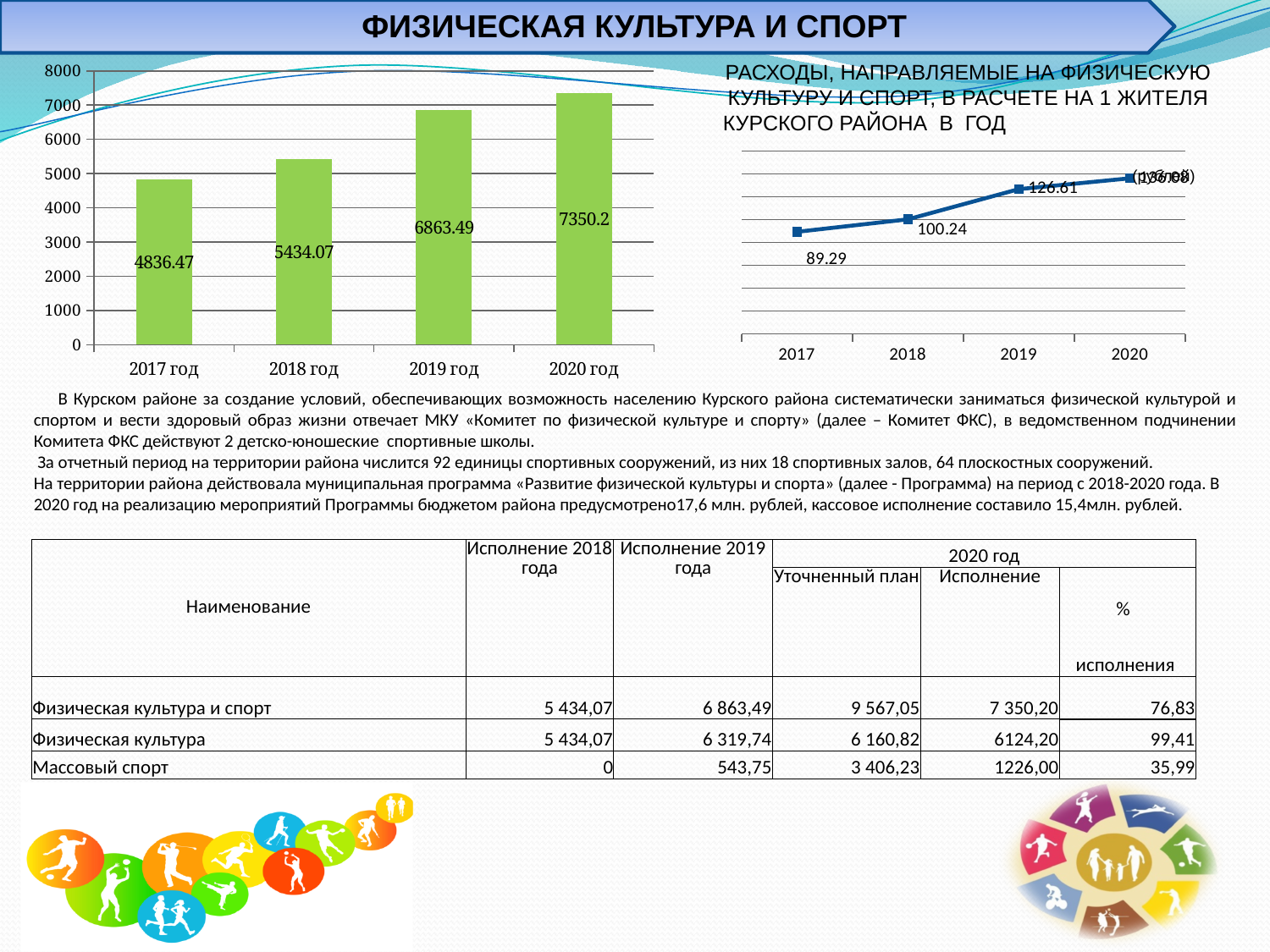
On the line chart on the right, which is larger, the value for 2019 or the value for 2018? 2019 On the line chart titled 'РАСХОДЫ, НАПРАВЛЯЕМЫЕ НА ФИЗИЧЕСКУЮ КУЛЬТУРУ И СПОРТ, В РАСЧЕТЕ НА 1 ЖИТЕЛЯ КУРСКОГО РАЙОНА В ГОД', what is the value for 2018? 100.24 On the bar chart on the left, which year has the highest value? 2020 год On the bar chart on the left, how many years are shown? 4 What kind of chart is the chart on the left of the slide? bar chart On the bar chart on the left, do the values rise or fall from 2017 год to 2020 год? rise On the bar chart on the left, what is the value for 2019 год? 6863.49 On the line chart titled 'РАСХОДЫ, НАПРАВЛЯЕМЫЕ НА ФИЗИЧЕСКУЮ КУЛЬТУРУ И СПОРТ, В РАСЧЕТЕ НА 1 ЖИТЕЛЯ КУРСКОГО РАЙОНА В ГОД', what is the difference between the values for 2019 and 2017? 37.32 On the bar chart on the left, is the value for 2018 год greater or less than 5000? greater On the bar chart on the left, what is the difference between the values for 2020 год and 2019 год? 486.71 On the bar chart on the left, which year has the lowest value? 2017 год On the bar chart on the left, what is the value for 2017 год? 4836.47